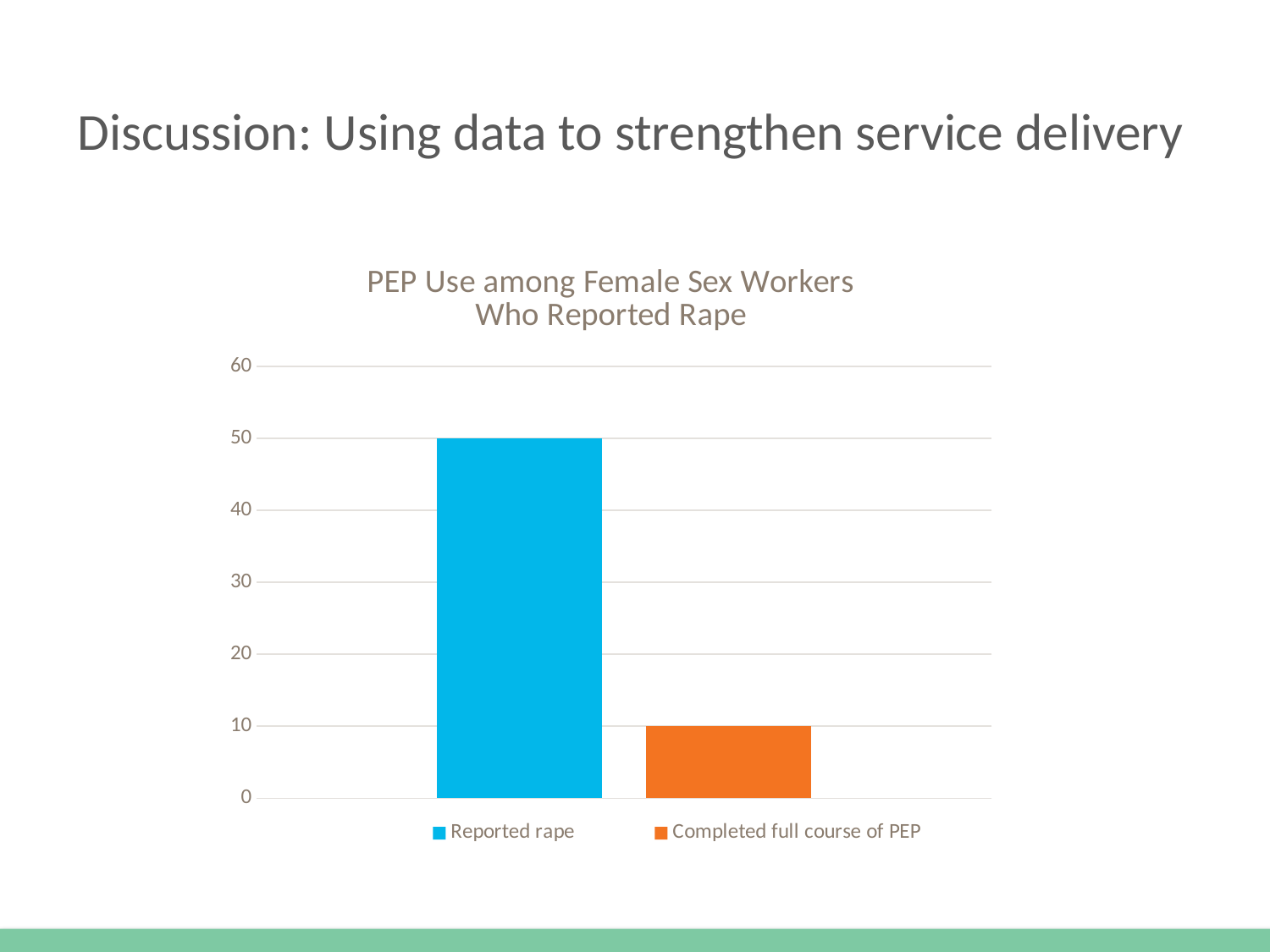
What is the value for Reported rape? 50 Which series has the highest value? Reported rape Is the value for Reported rape greater or less than 40? greater How many bars are plotted in the chart? 2 What is the difference between the value for Reported rape and the value for Completed full course of PEP? 40 What colour is the bar for Completed full course of PEP? Orange Which is larger, the value for Reported rape or the value for Completed full course of PEP? Reported rape What is the title of the chart? PEP Use among Female Sex Workers Who Reported Rape Which series has the lowest value? Completed full course of PEP What kind of chart is shown on the slide? Bar chart How many series does the legend list? 2 What is the value for Completed full course of PEP? 10